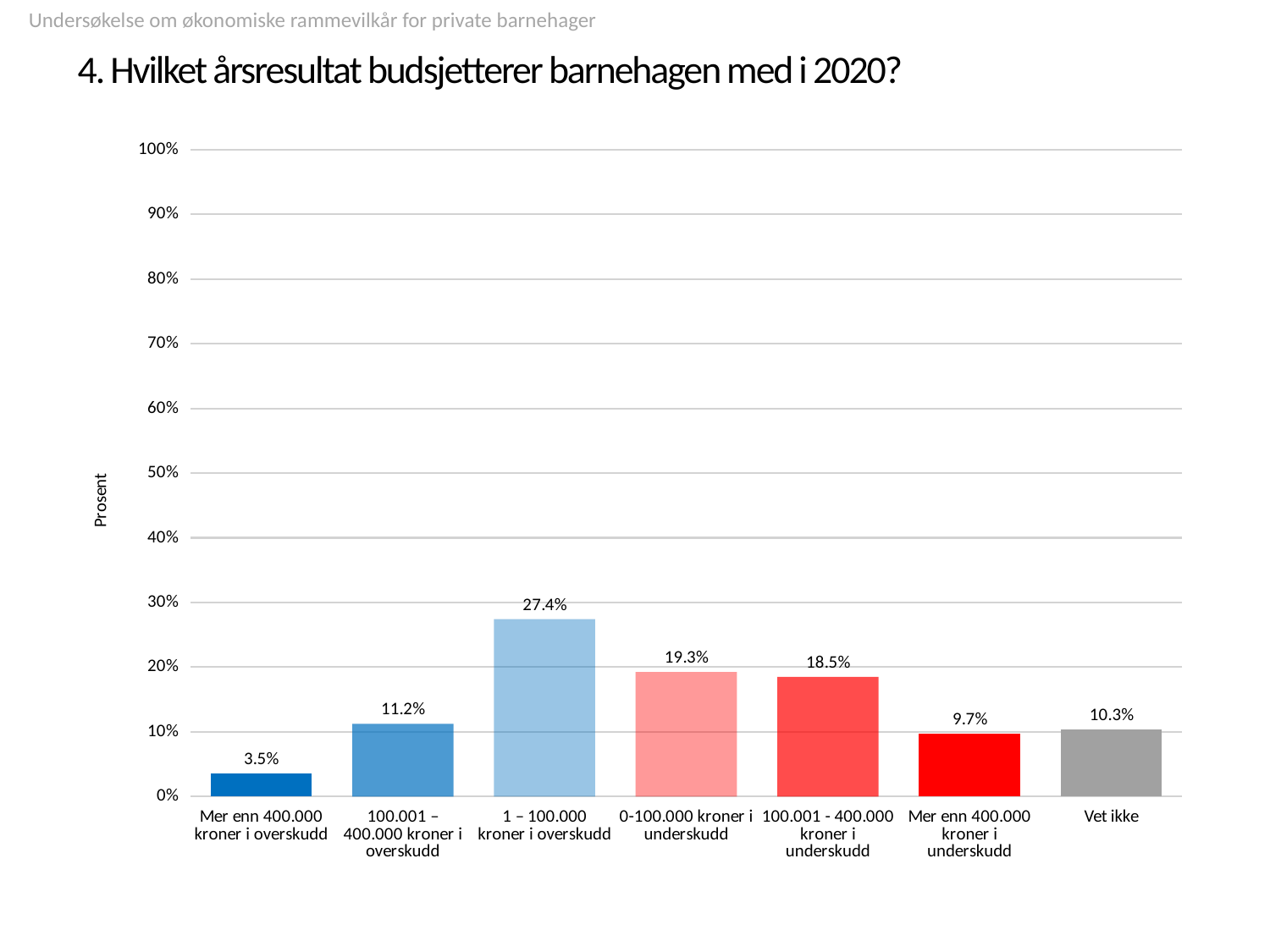
Which is larger: '100.001 – 400.000 kroner i overskudd' or 'Vet ikke'? 100.001 – 400.000 kroner i overskudd Which category has the highest value? 1 – 100.000 kroner i overskudd How many categories are shown on the x axis? 7 What is the value for 'Mer enn 400.000 kroner i underskudd'? 9.7% What percentage of respondents budget for '1 – 100.000 kroner i overskudd' in 2020? 27.4% What is the value for 'Vet ikke'? 10.3% What is the label of the y axis? Prosent What is the difference between the highest and lowest values? 23.9% What kind of chart is shown on the slide? bar chart Is the value for '1 – 100.000 kroner i overskudd' greater or less than 30%? less Which category has the lowest value? Mer enn 400.000 kroner i overskudd What is the difference between '0-100.000 kroner i underskudd' and '100.001 - 400.000 kroner i underskudd'? 0.8%